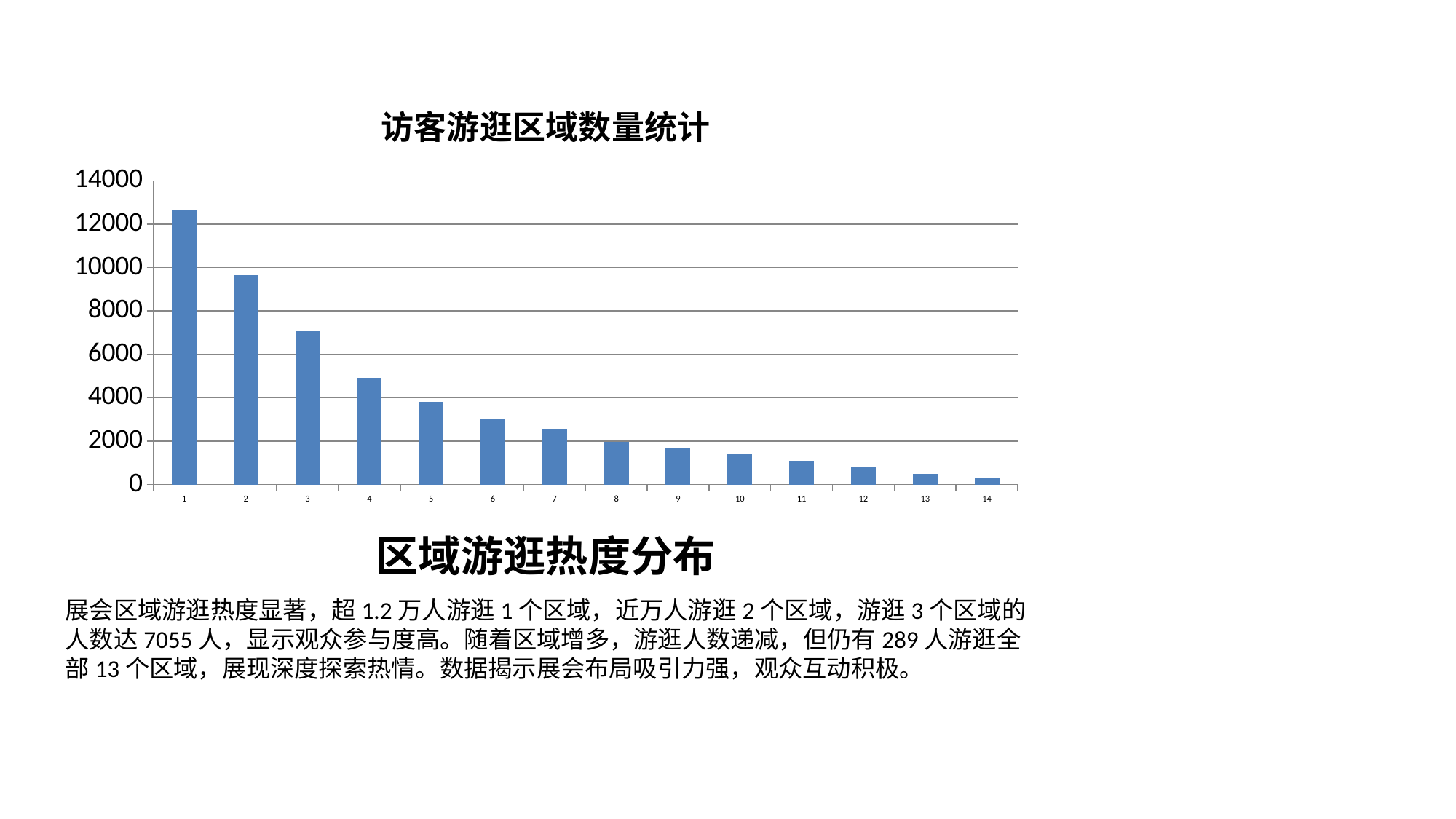
Which has the larger value, category 5 or category 9? category 5 Which category has the lowest bar in the chart? 14 Is the value for category 2 greater or less than 10000? less What kind of chart is shown on the slide? bar chart Is the value for category 1 greater or less than 12000? greater Do the bar values rise or fall as you move from category 1 to category 14? fall What is the title of the chart? 访客游逛区域数量统计 Which category has the highest bar in the chart? 1 Is the value for category 6 greater or less than 2000? greater How many categories are plotted along the x axis of the chart? 14